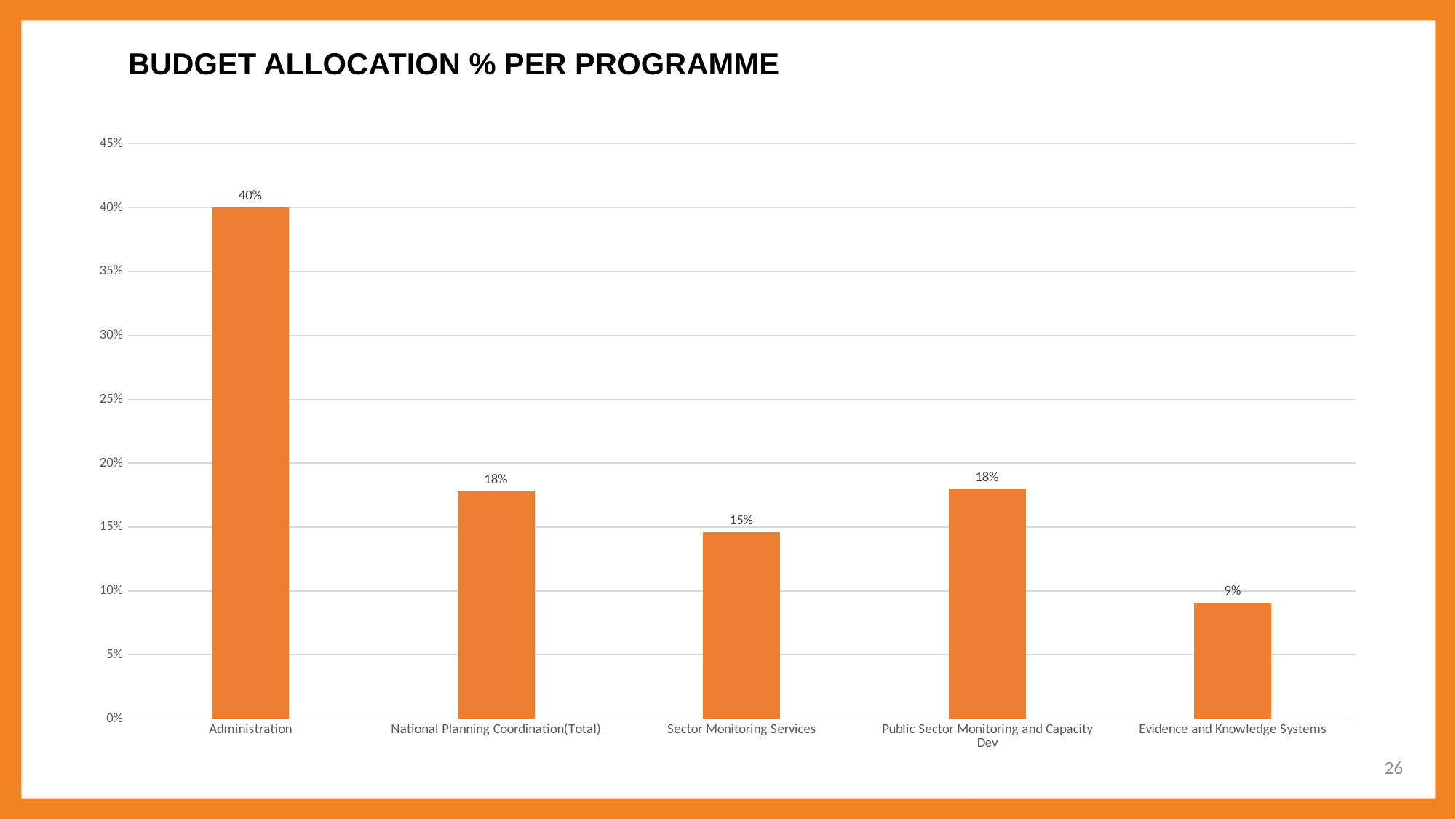
How many programmes are shown in the chart? 5 What is the budget allocation percentage for Evidence and Knowledge Systems? 9% Which has a larger budget allocation, Sector Monitoring Services or Evidence and Knowledge Systems? Sector Monitoring Services Is the value for Public Sector Monitoring and Capacity Dev greater or less than 20%? less Which programme has the highest budget allocation? Administration What is the title of the chart? BUDGET ALLOCATION % PER PROGRAMME What is the budget allocation percentage for Administration? 40% What is the budget allocation percentage for Sector Monitoring Services? 15% What is the budget allocation percentage for National Planning Coordination(Total)? 18% What is the difference in budget allocation between Administration and Sector Monitoring Services? 25% Which programme has the lowest budget allocation? Evidence and Knowledge Systems What kind of chart is shown on the slide? Bar chart